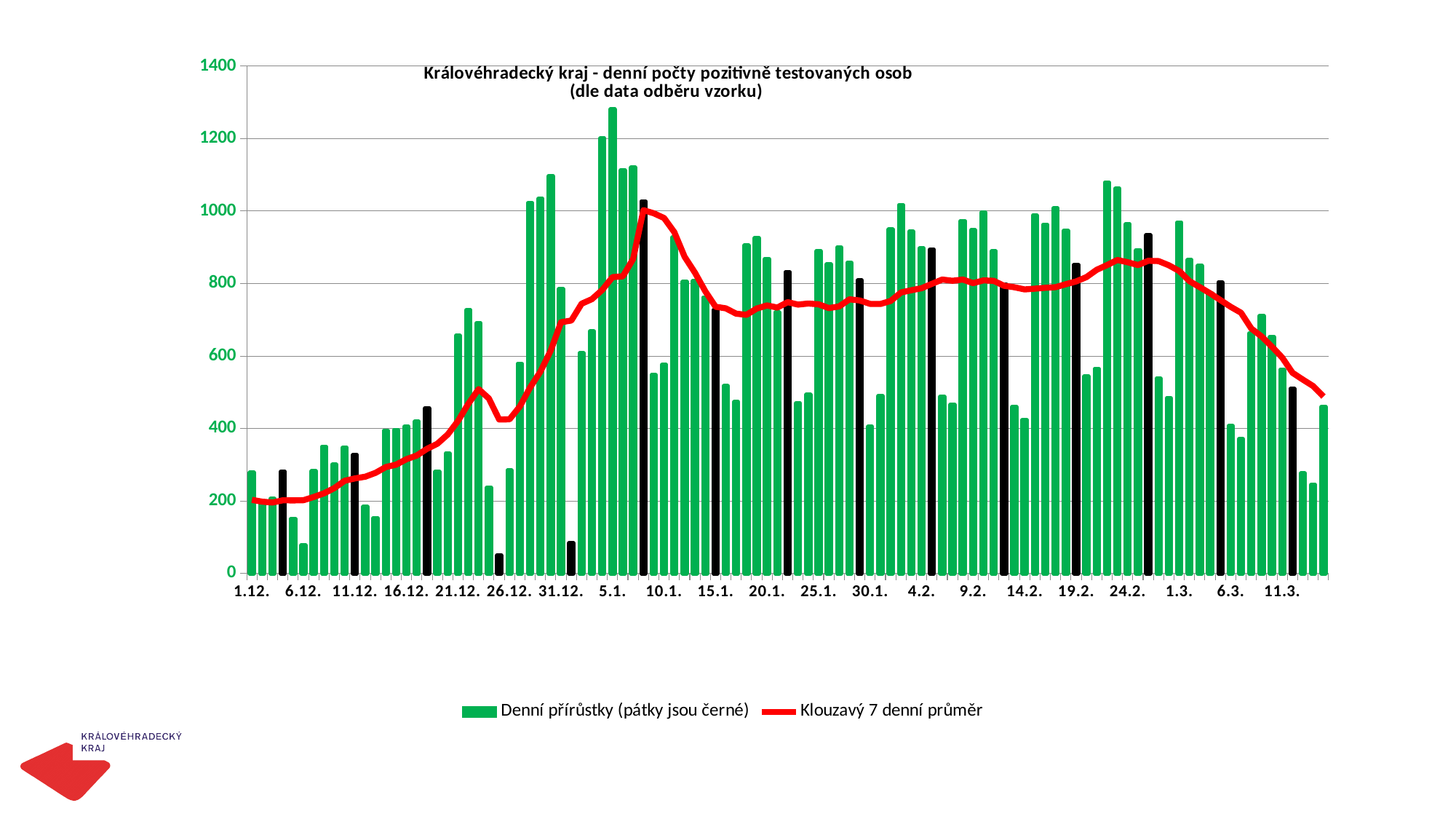
What kind of chart is shown on the slide? bar chart with a line Is the value for 15.1. greater or less than 600? greater Is the value for 6.12. greater or less than 200? less Which is larger, the value for 1.12. or the value for 21.12.? 21.12. Is the value for 26.12. greater or less than 400? less What is the title of the chart? Královéhradecký kraj - denní počty pozitivně testovaných osob (dle data odběru vzorku) How many series does the legend list? 2 Does the 7-day moving average line rise or fall between 1.12. and 5.1.? rise According to the legend, what colour are the bars for Fridays? black